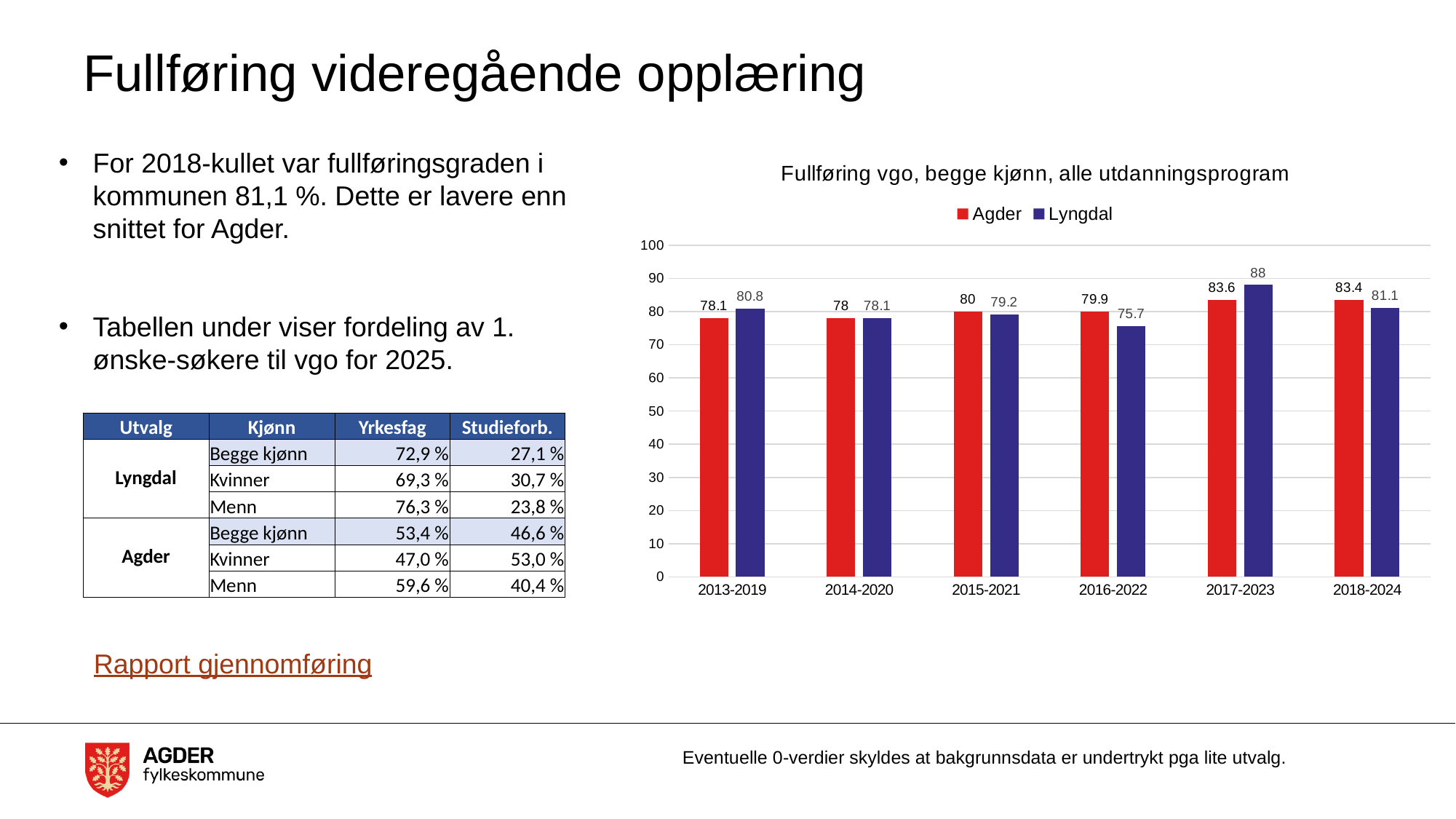
What is the value for Lyngdal in 2016-2022? 75.7 How many series does the legend list? 2 What is the value for Agder in 2016-2022? 79.9 What kind of chart is shown? Bar chart How many periods are shown on the x axis? 6 Which period has the lowest value for Agder? 2014-2020 What is the value for Lyngdal in 2018-2024? 81.1 What is the title of the chart? Fullføring vgo, begge kjønn, alle utdanningsprogram Which is larger in 2016-2022, Agder or Lyngdal? Agder Which period has the highest value for Lyngdal? 2017-2023 Which period has the lowest value for Lyngdal? 2016-2022 What is the difference between Lyngdal and Agder in 2017-2023? 4.4